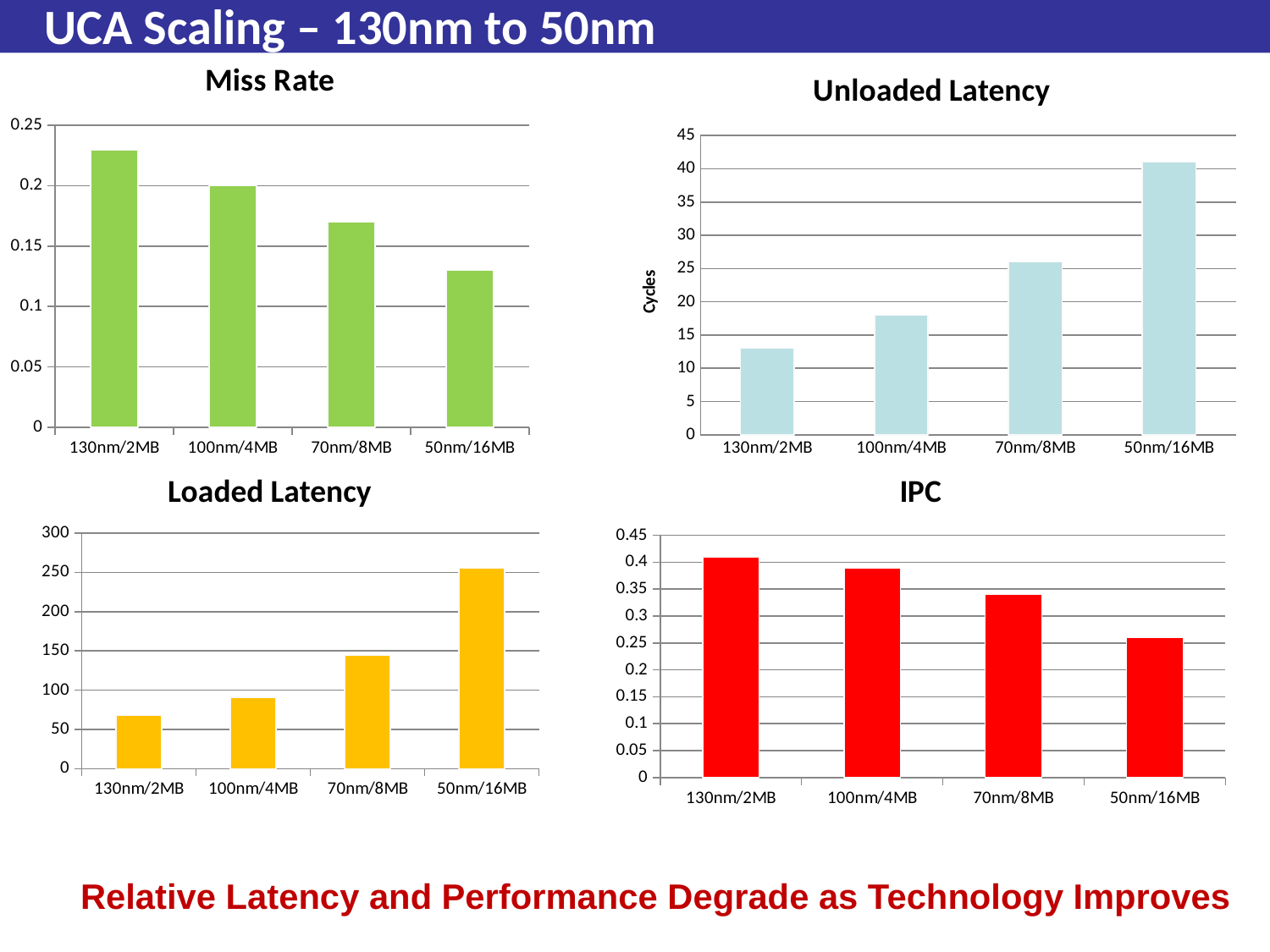
In the Unloaded Latency chart, is the value for 70nm/8MB greater or less than 20? greater In the Unloaded Latency chart, what is the label on the vertical axis? Cycles What kind of chart is the IPC chart? bar chart In the Loaded Latency chart, is the value for 50nm/16MB greater or less than 200? greater In the Loaded Latency chart, which category has the lowest value? 130nm/2MB In the IPC chart, is the value for 50nm/16MB greater or less than 0.3? less In the Unloaded Latency chart, which category has the highest value? 50nm/16MB In the Miss Rate chart, which category has the highest miss rate? 130nm/2MB In the IPC chart, which is larger, the value for 130nm/2MB or the value for 50nm/16MB? 130nm/2MB In the Loaded Latency chart, how many categories are shown on the x axis? 4 In the Miss Rate chart, do the values rise or fall from left to right along the x axis? fall